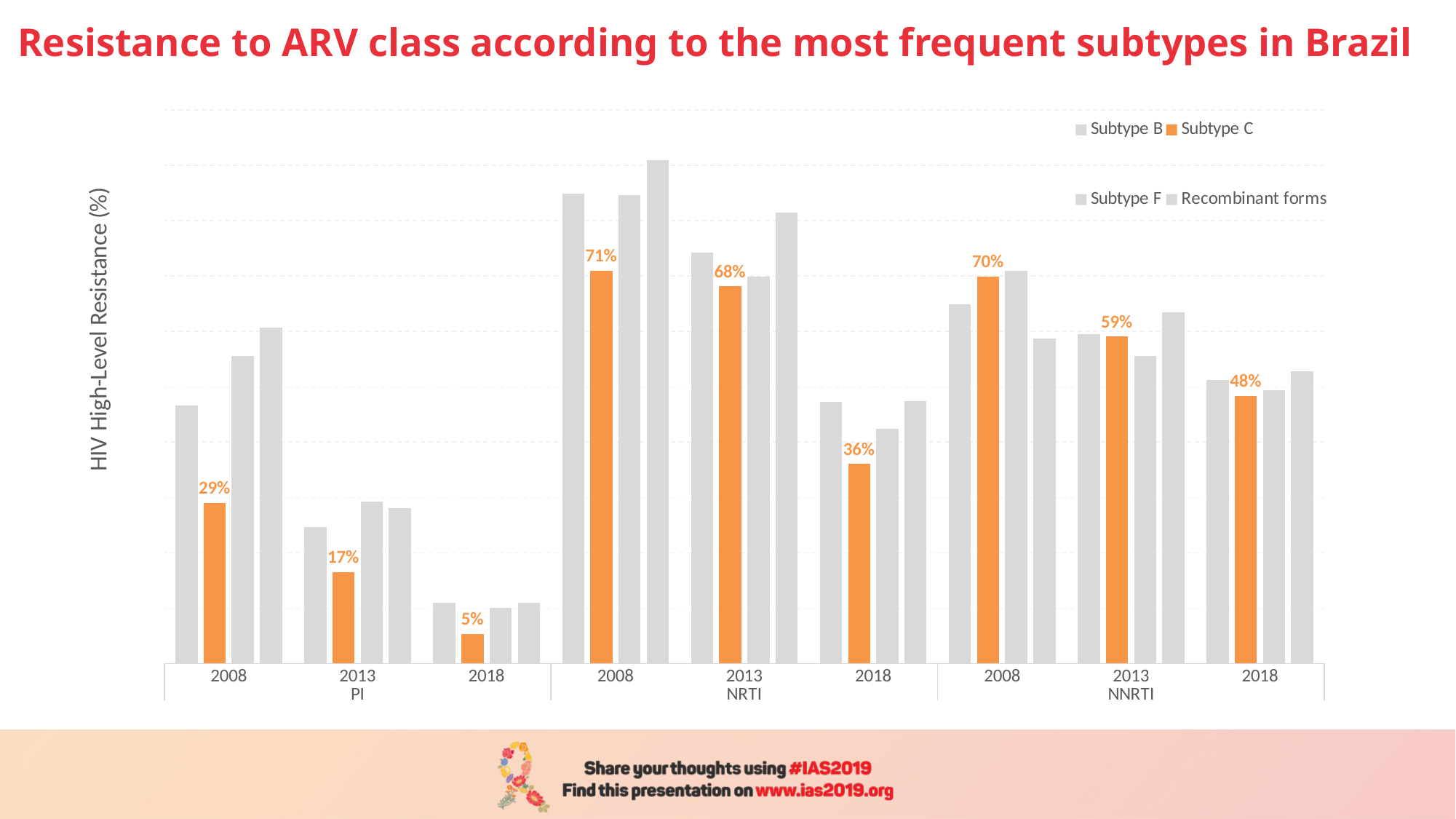
What is the Subtype C value for NRTI in 2013? 68% What kind of chart is shown on the slide? Bar chart What is the difference between the Subtype C values for NNRTI in 2008 and NNRTI in 2013? 11% How many series does the legend list? 4 What is the Subtype C value for PI in 2008? 29% What is the difference between the Subtype C values for NRTI in 2008 and NRTI in 2018? 35% Which year and ARV class has the highest Subtype C value? NRTI 2008 Which is larger, the Subtype C value for NRTI in 2013 or for NNRTI in 2013? NRTI in 2013 What is the Subtype C value for PI in 2018? 5% Which year and ARV class has the lowest Subtype C value? PI 2018 What is the Subtype C value for NNRTI in 2018? 48% Do the Subtype C values for PI rise or fall from 2008 to 2018? Fall